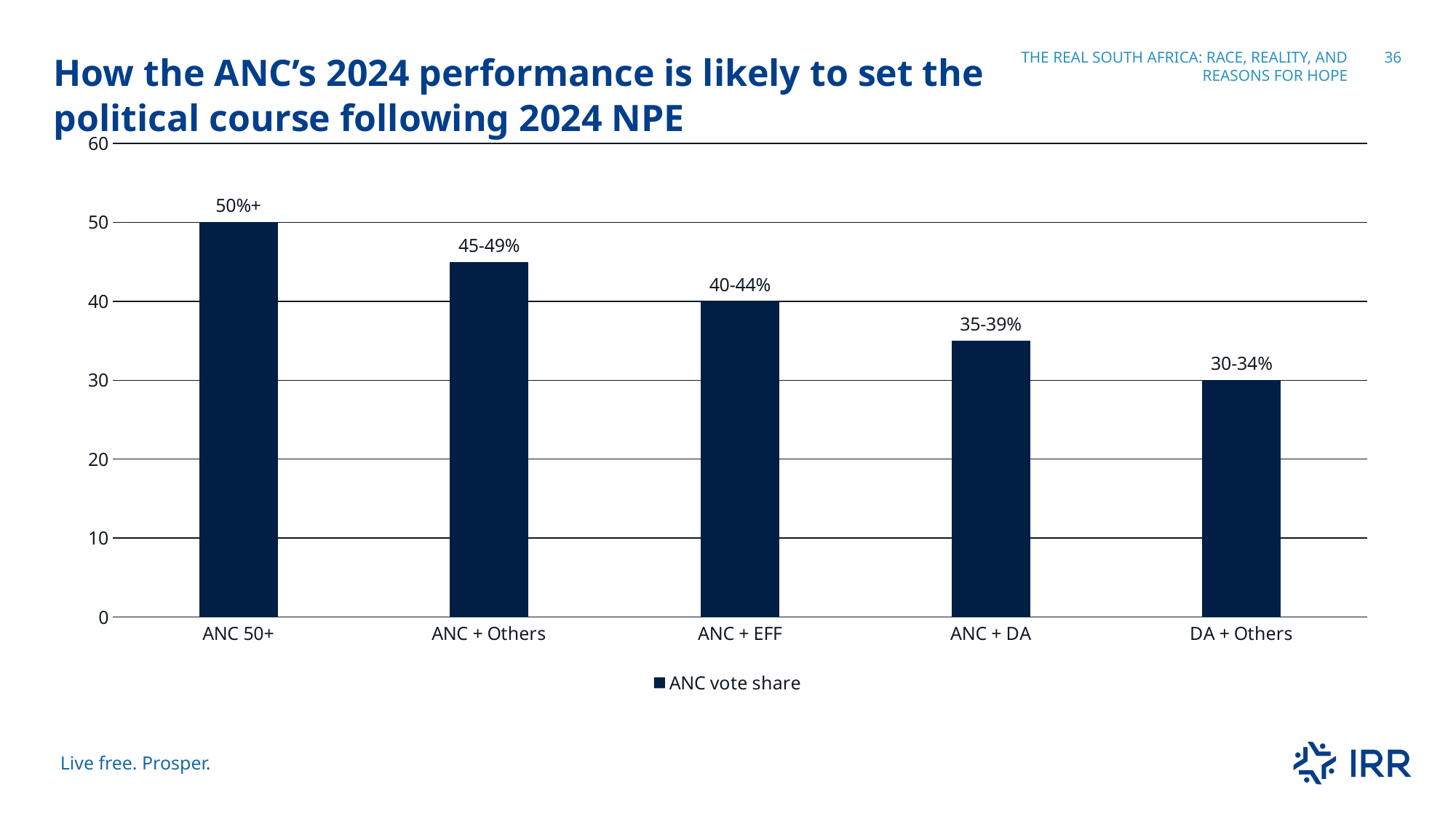
Which category has the tallest bar? ANC 50+ What data label is shown for the ANC 50+ bar? 50%+ Do the bar heights rise or fall from left to right across the x axis? fall What data label is shown for the DA + Others bar? 30-34% How many categories are shown on the x axis? 5 Which category has the shortest bar? DA + Others Is the bar for ANC + EFF greater or less than 30? greater What data label is shown for the ANC + DA bar? 35-39% What data label is shown for the ANC + Others bar? 45-49% Which bar is taller, ANC + Others or ANC + DA? ANC + Others What data label is shown for the ANC + EFF bar? 40-44% How many series does the legend list? 1